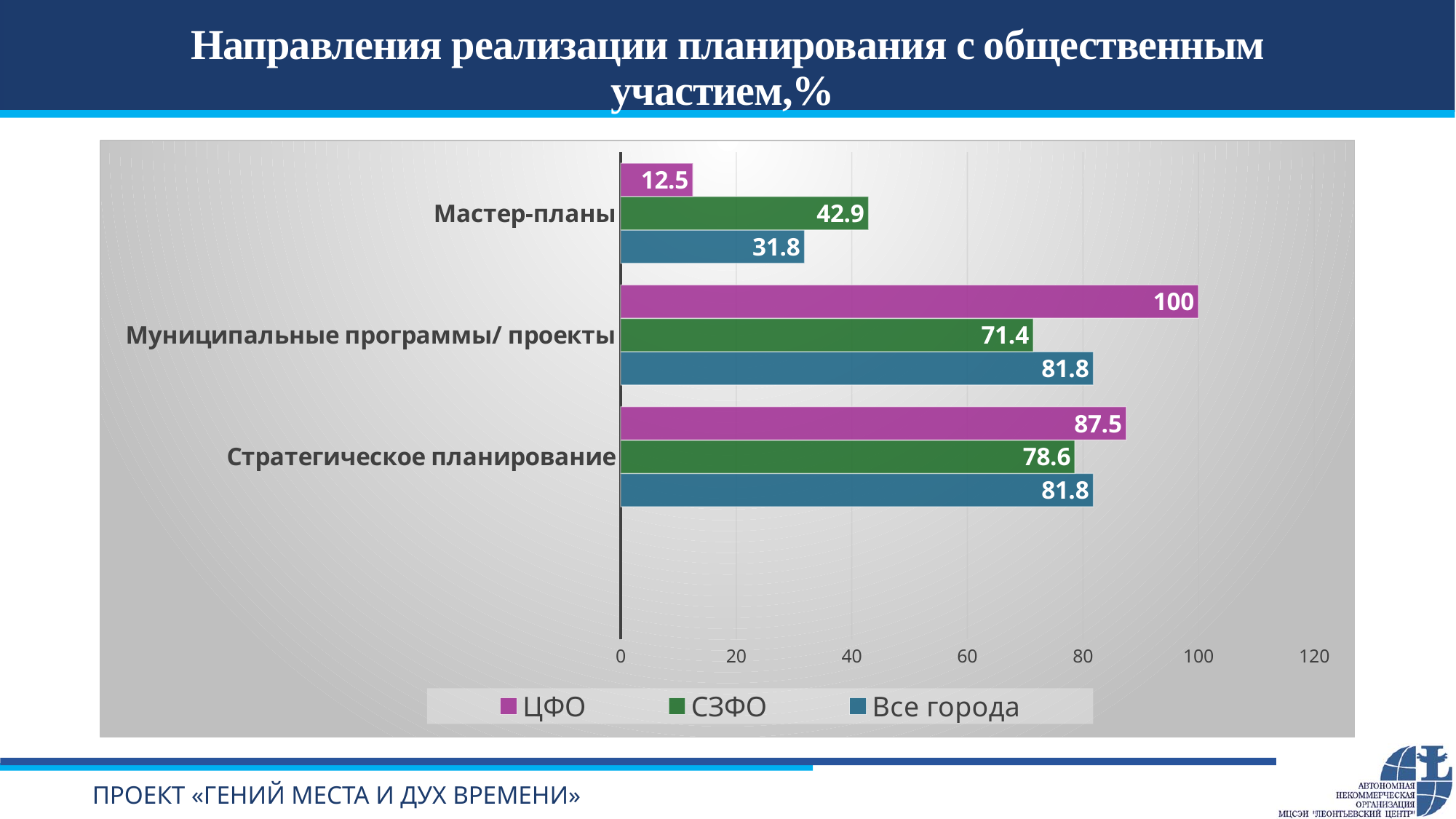
What is the value for СЗФО in the Муниципальные программы/ проекты category? 71.4 What is the value for ЦФО in the Мастер-планы category? 12.5 Is the value for ЦФО in the Мастер-планы category greater or less than 20? less Which category has the lowest value for Все города? Мастер-планы Which colour represents the Все города series in the legend? blue How many series does the legend list? 3 Which category has the highest value for ЦФО? Муниципальные программы/ проекты What is the value for Все города in the Стратегическое планирование category? 81.8 How many categories are shown on the chart? 3 What kind of chart is shown on the slide? bar chart In the Мастер-планы category, which is larger: the value for СЗФО or the value for Все города? СЗФО What is the difference between the ЦФО and СЗФО values in the Стратегическое планирование category? 8.9